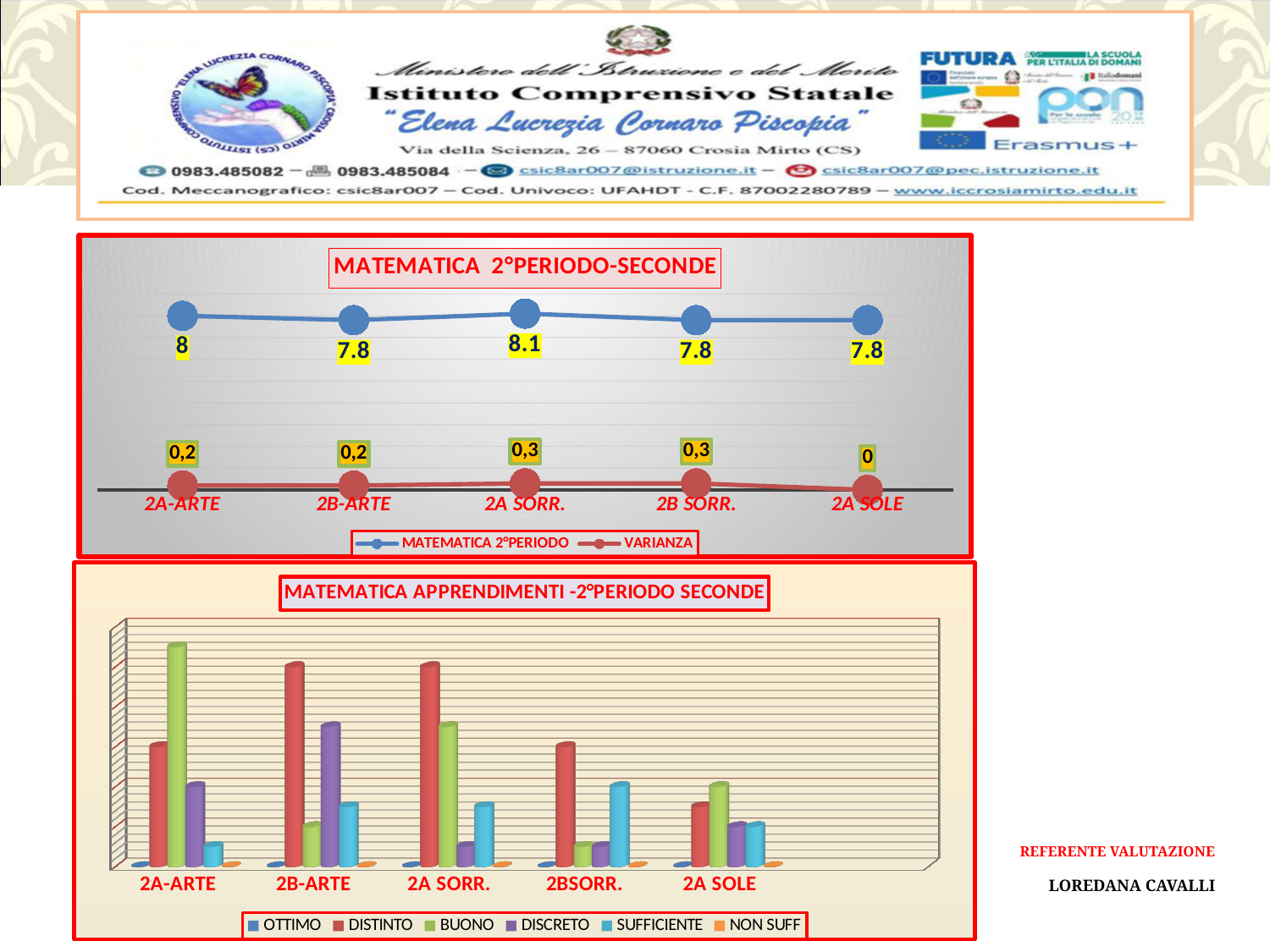
What kind of chart is the top chart (MATEMATICA 2°PERIODO-SECONDE)? Line chart In the top chart (MATEMATICA 2°PERIODO-SECONDE), which class has the highest MATEMATICA 2°PERIODO value? 2A SORR. In the bottom chart (MATEMATICA APPRENDIMENTI -2°PERIODO SECONDE), which series has the tallest bar for 2A-ARTE? BUONO In the top chart (MATEMATICA 2°PERIODO-SECONDE), which class has the lowest VARIANZA value? 2A SOLE In the top chart (MATEMATICA 2°PERIODO-SECONDE), what is the MATEMATICA 2°PERIODO value for 2A SORR.? 8.1 In the top chart (MATEMATICA 2°PERIODO-SECONDE), what is the difference between the MATEMATICA 2°PERIODO values for 2A SORR. and 2B-ARTE? 0.3 In the top chart (MATEMATICA 2°PERIODO-SECONDE), what is the MATEMATICA 2°PERIODO value for 2A-ARTE? 8 In the top chart (MATEMATICA 2°PERIODO-SECONDE), what is the VARIANZA value for 2A SOLE? 0 In the top chart (MATEMATICA 2°PERIODO-SECONDE), how many series does the legend list? 2 In the bottom chart (MATEMATICA APPRENDIMENTI -2°PERIODO SECONDE), how many classes are shown on the x axis? 5 In the bottom chart (MATEMATICA APPRENDIMENTI -2°PERIODO SECONDE), how many series does the legend list? 6 In the top chart (MATEMATICA 2°PERIODO-SECONDE), which is larger: the VARIANZA for 2A SORR. or for 2A-ARTE? 2A SORR.